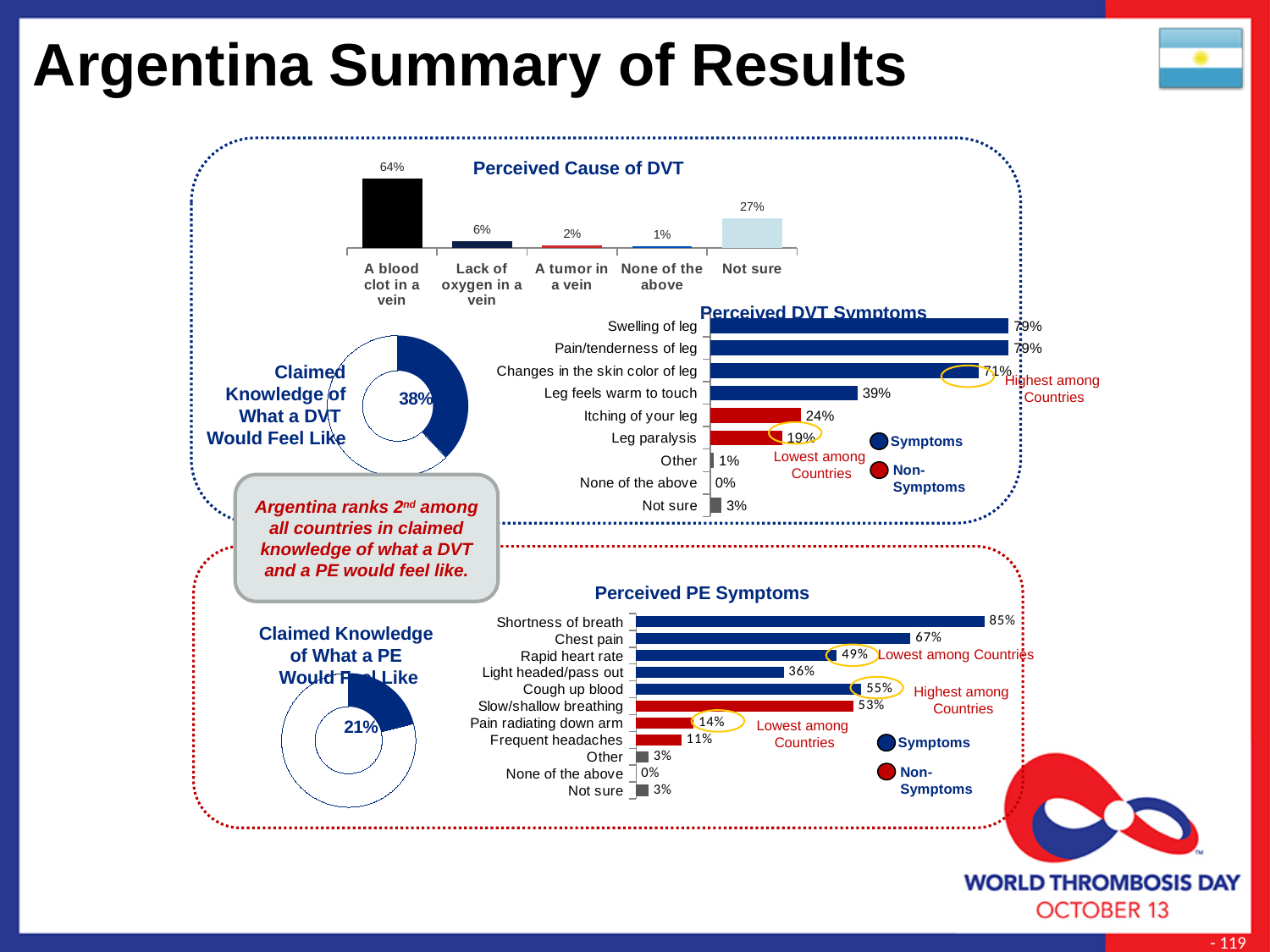
What value is shown in the Claimed Knowledge of What a DVT Would Feel Like donut chart? 38% In the Perceived Cause of DVT chart, what percentage is shown for 'A blood clot in a vein'? 64% In the Perceived DVT Symptoms chart, what percentage is shown for 'Leg feels warm to touch'? 39% What value is shown in the Claimed Knowledge of What a PE Would Feel Like donut chart? 21% In the Perceived PE Symptoms chart, which symptom has the highest value? Shortness of breath In the Perceived Cause of DVT chart, what is the difference between 'Not sure' and 'Lack of oxygen in a vein'? 21% In the Perceived Cause of DVT chart, how many categories are shown? 5 In the Perceived DVT Symptoms chart, what is the difference between 'Swelling of leg' and 'Changes in the skin color of leg'? 8% In the Perceived Cause of DVT chart, which category has the lowest value? None of the above What type of chart is the Perceived PE Symptoms chart? Bar chart In the Perceived PE Symptoms chart, what percentage is shown for 'Slow/shallow breathing'? 53% In the Perceived DVT Symptoms chart, which is larger, 'Itching of your leg' or 'Leg paralysis'? Itching of your leg